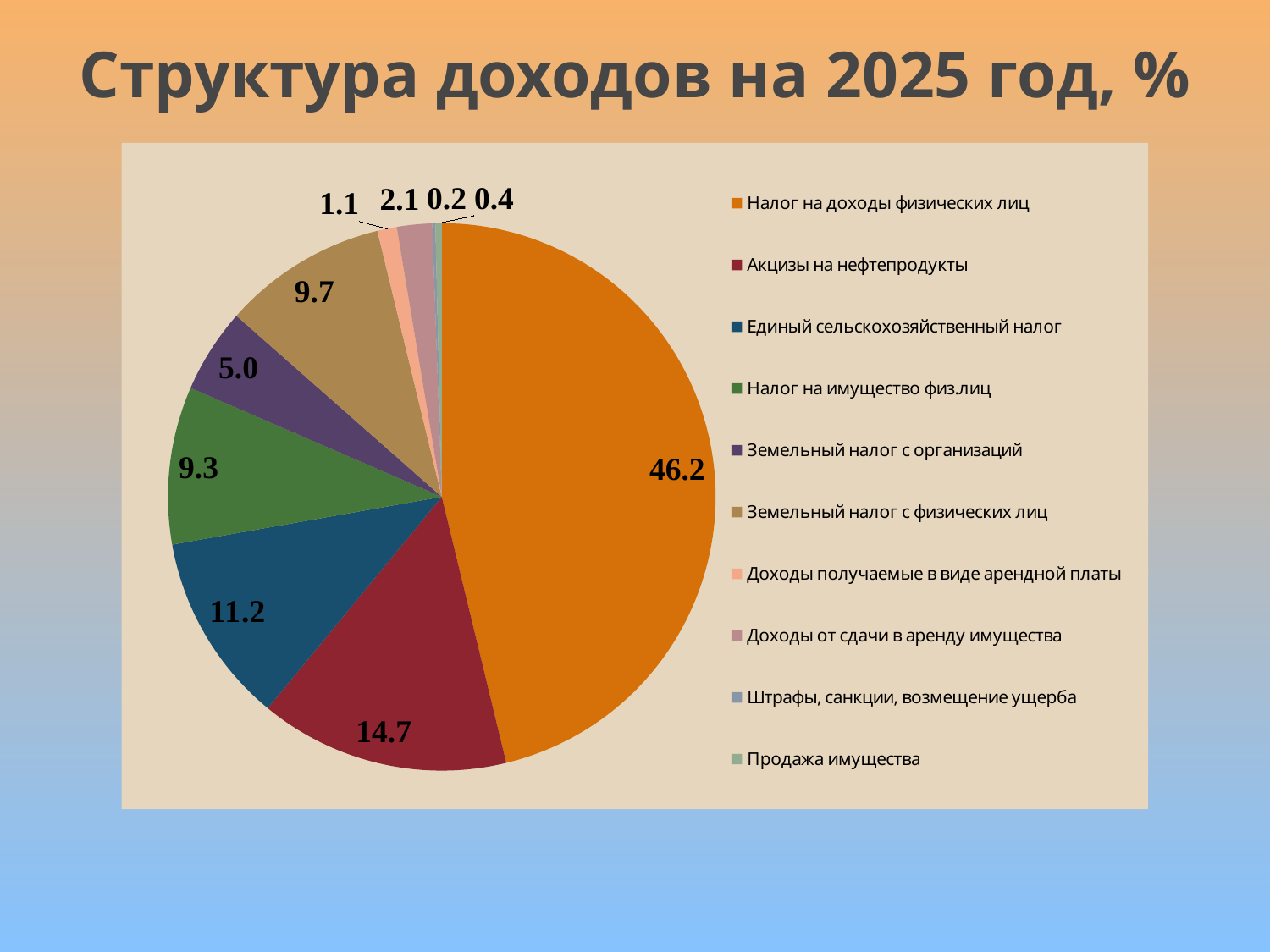
What is the difference between the values for Налог на доходы физических лиц and Акцизы на нефтепродукты? 31.5 What is the value for Налог на доходы физических лиц? 46.2 Which category has the largest share of the pie? Налог на доходы физических лиц What is the value for Единый сельскохозяйственный налог? 11.2 Which is larger, the value for Единый сельскохозяйственный налог or the value for Налог на имущество физ.лиц? Единый сельскохозяйственный налог What kind of chart is shown on the slide? pie chart What is the value for Акцизы на нефтепродукты? 14.7 What is the title of the chart on the slide? Структура доходов на 2025 год, % How many categories does the legend of the pie chart list? 10 What is the value for Земельный налог с организаций? 5.0 What colour is the slice for Налог на доходы физических лиц? orange Which category has the smallest share of the pie? Штрафы, санкции, возмещение ущерба